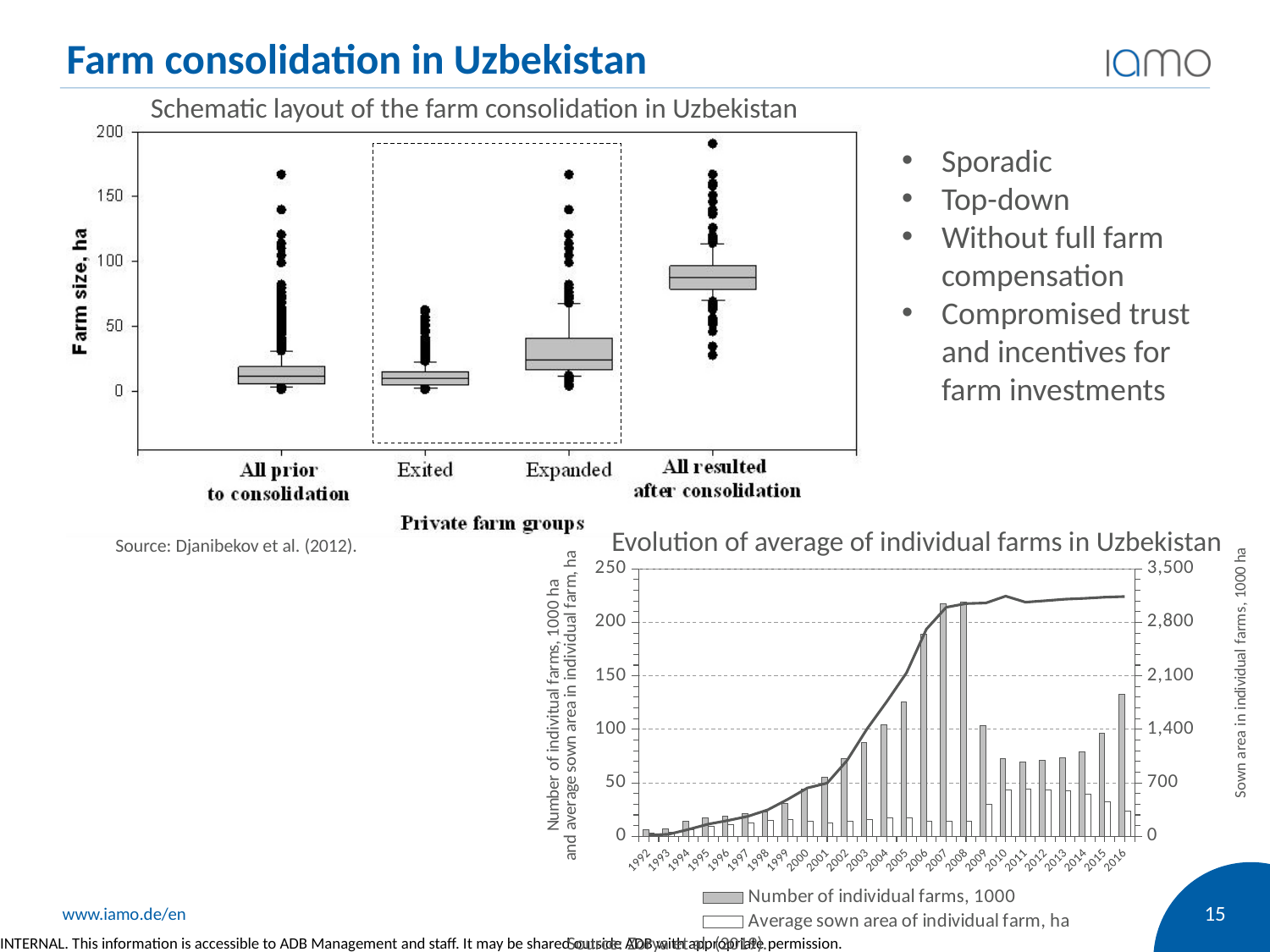
In the 'Schematic layout of the farm consolidation in Uzbekistan' chart, is the median farm size for 'All resulted after consolidation' greater or less than 50 ha? greater In the 'Schematic layout of the farm consolidation in Uzbekistan' chart, what is the label of the y axis? Farm size, ha In the 'Evolution of average of individual farms in Uzbekistan' chart, which year has the lowest number of individual farms? 1992 What kind of chart is the 'Schematic layout of the farm consolidation in Uzbekistan' chart? Box plot In the 'Evolution of average of individual farms in Uzbekistan' chart, does the sown area in individual farms line generally rise or fall from 1992 to 2016? rise In the 'Evolution of average of individual farms in Uzbekistan' chart, is the number of individual farms in 2016 greater or less than 100? greater In the 'Schematic layout of the farm consolidation in Uzbekistan' chart, which private farm group has the highest median farm size? All resulted after consolidation In the 'Evolution of average of individual farms in Uzbekistan' chart, is the number of individual farms in 2010 greater or less than 100? less In the 'Schematic layout of the farm consolidation in Uzbekistan' chart, which group has the higher median farm size, 'Exited' or 'Expanded'? Expanded How many private farm groups are shown on the x axis of the 'Schematic layout of the farm consolidation in Uzbekistan' chart? 4 In the 'Evolution of average of individual farms in Uzbekistan' chart, how many years are shown on the x axis? 25 In the 'Evolution of average of individual farms in Uzbekistan' chart, what is the maximum value shown on the right-hand axis? 3,500